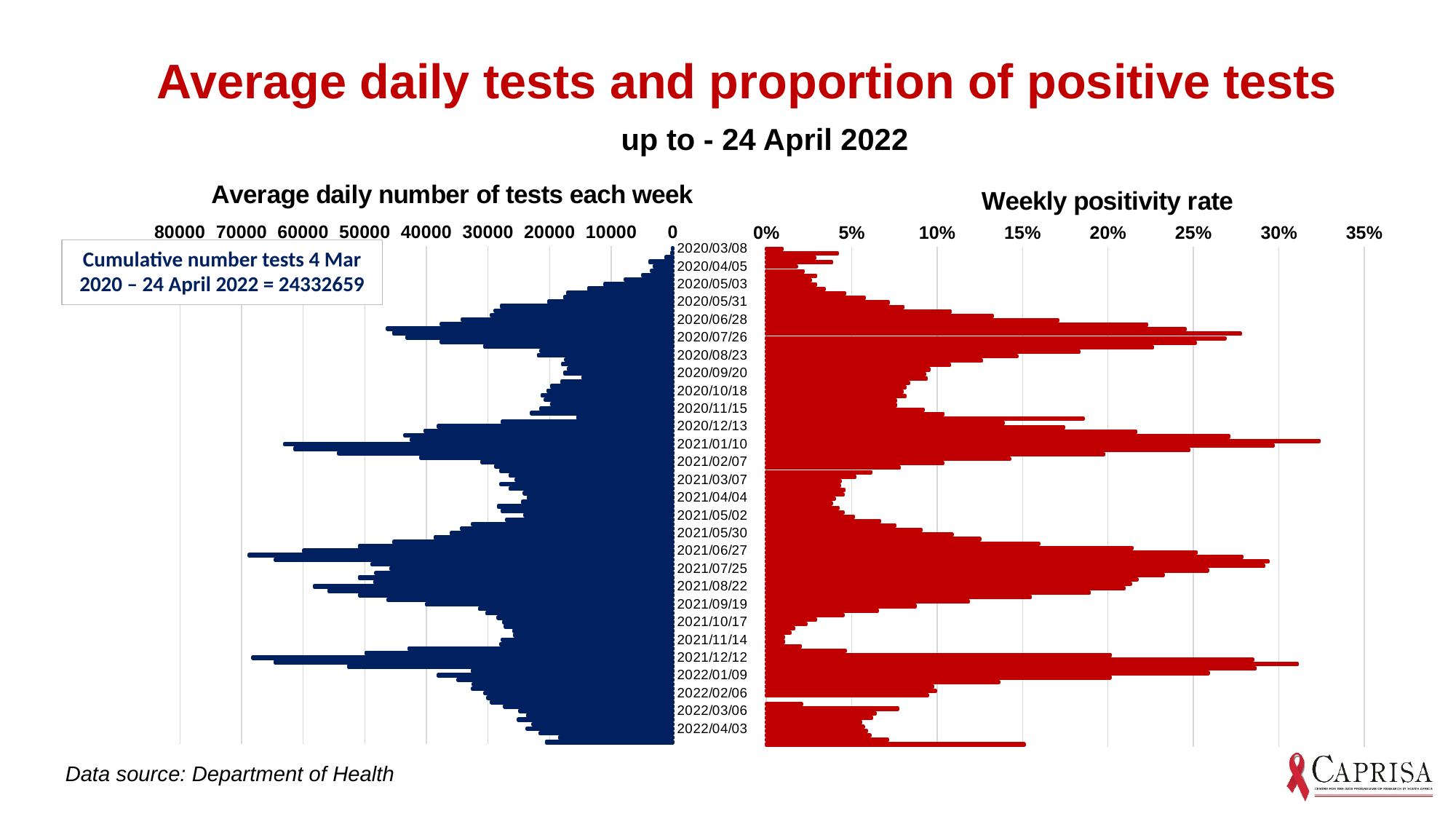
In the 'Weekly positivity rate' chart, is the value for 2021/04/04 greater or less than 5%? less What is the highest value shown on the x axis of the 'Weekly positivity rate' chart? 35% In the 'Weekly positivity rate' chart, is the value for 2021/12/12 greater or less than 25%? greater What kind of chart is the 'Average daily number of tests each week' chart? bar chart What kind of chart is the 'Weekly positivity rate' chart? bar chart In the 'Weekly positivity rate' chart, is the value for 2021/11/14 greater or less than 5%? less What colour are the bars in the 'Weekly positivity rate' chart? red In the 'Weekly positivity rate' chart, do the values rise or fall from 2020/03/08 to 2020/07/26? rise